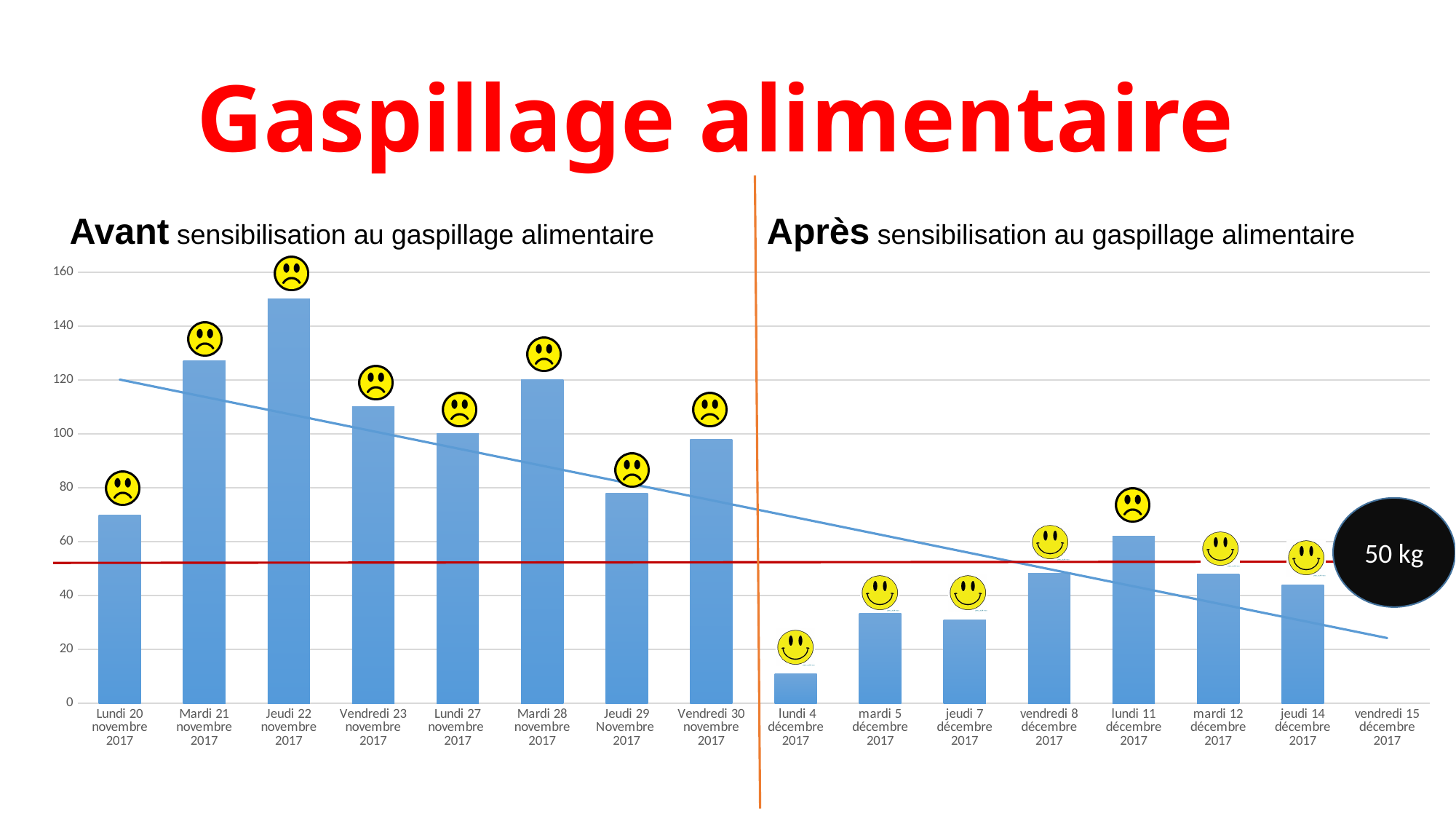
What kind of chart is shown on the slide? bar chart Which is larger, the value for lundi 11 décembre 2017 or for mardi 5 décembre 2017? lundi 11 décembre 2017 Is the value for mardi 5 décembre 2017 greater or less than 40? less Is the value for Jeudi 22 novembre 2017 greater or less than 140? greater What value is labelled on the red horizontal line across the chart? 50 kg Which is larger, the value for Mardi 21 novembre 2017 or for Vendredi 23 novembre 2017? Mardi 21 novembre 2017 Is the value for Mardi 21 novembre 2017 greater or less than 120? greater Do the values generally rise or fall from the first date to the last date along the x axis? fall How many dates are listed along the x axis of the chart? 16 Which date has the highest bar in the chart? Jeudi 22 novembre 2017 Among the dates with a visible bar, which has the lowest value? lundi 4 décembre 2017